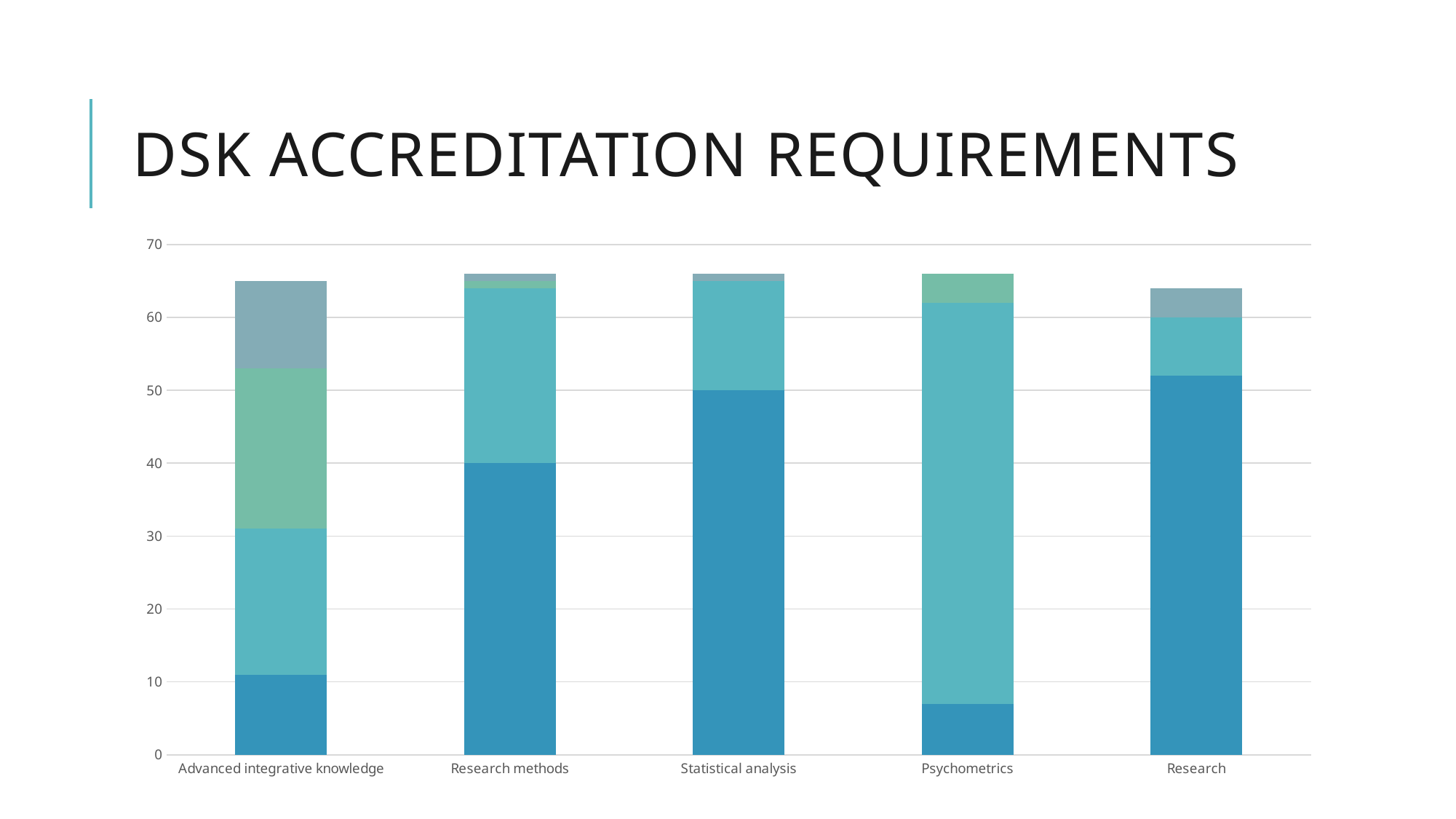
What kind of chart is shown on the slide? Stacked bar chart Is the total height of the bar for Advanced integrative knowledge greater or less than 60? greater How many categories are shown on the x axis of the chart? 5 What is the title of the slide containing the chart? DSK ACCREDITATION REQUIREMENTS Which has the larger bottom (dark blue) segment: Statistical analysis or Psychometrics? Statistical analysis Is the total height of the bar for Psychometrics greater or less than 60? greater What is the highest value shown on the chart's y axis? 70 Is the bottom (dark blue) segment of the Research bar greater or less than 40? greater Which category has the smallest bottom (dark blue) segment? Psychometrics